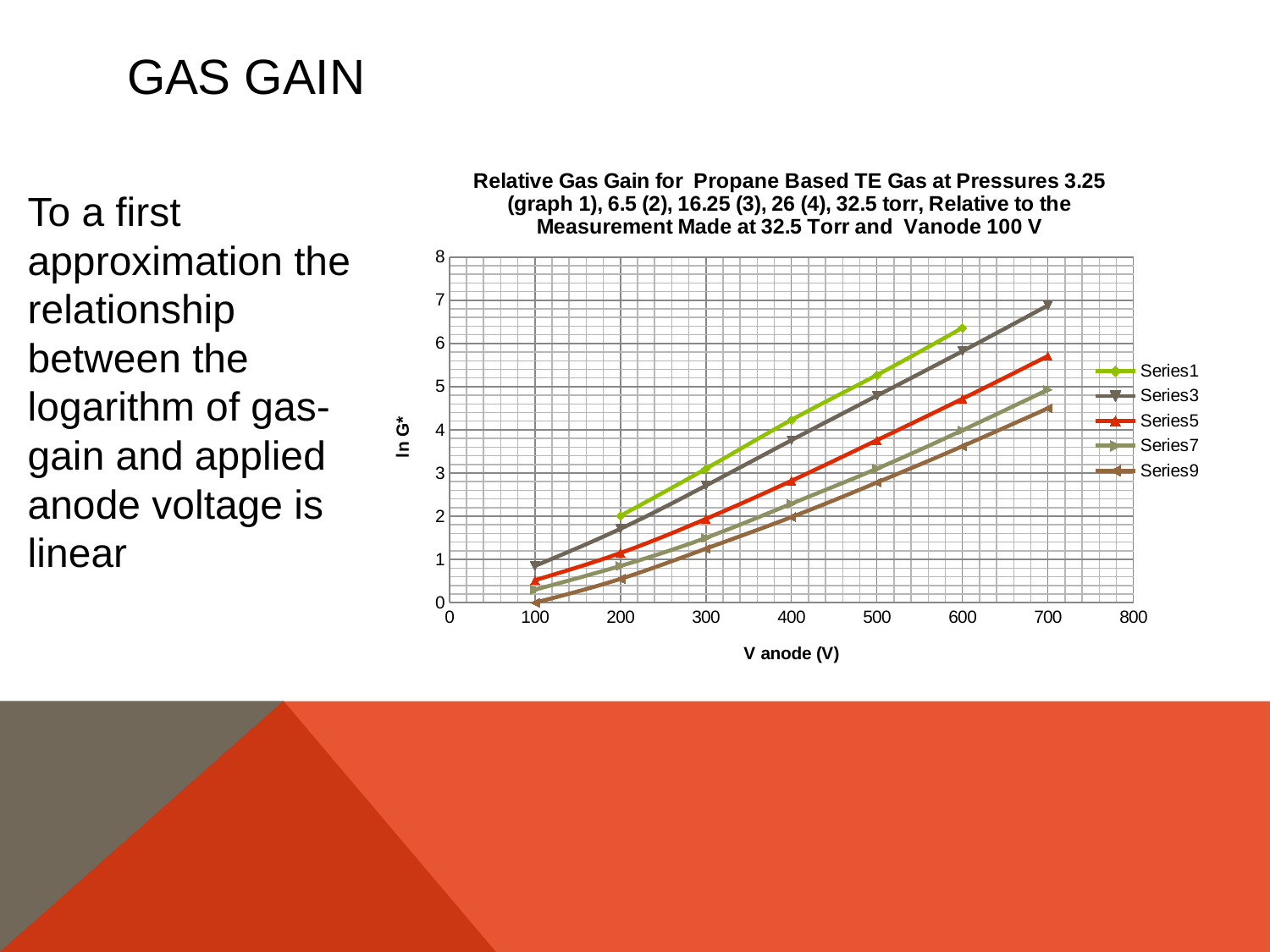
Is the value of Series1 at 600 V greater or less than 6? greater Which series reaches the highest ln G* value at 700 V? Series3 Which series has the lowest ln G* value at 700 V? Series9 How many series does the legend list? 5 Does ln G* rise or fall as V anode increases for Series1? rise At 500 V, which is larger: Series1 or Series5? Series1 How many data points are plotted for Series1? 5 What kind of chart is shown on the slide? line chart Is the value of Series9 at 700 V greater or less than 5? less Is the value of Series3 at 100 V greater or less than 1? less What is the label of the x axis? V anode (V)